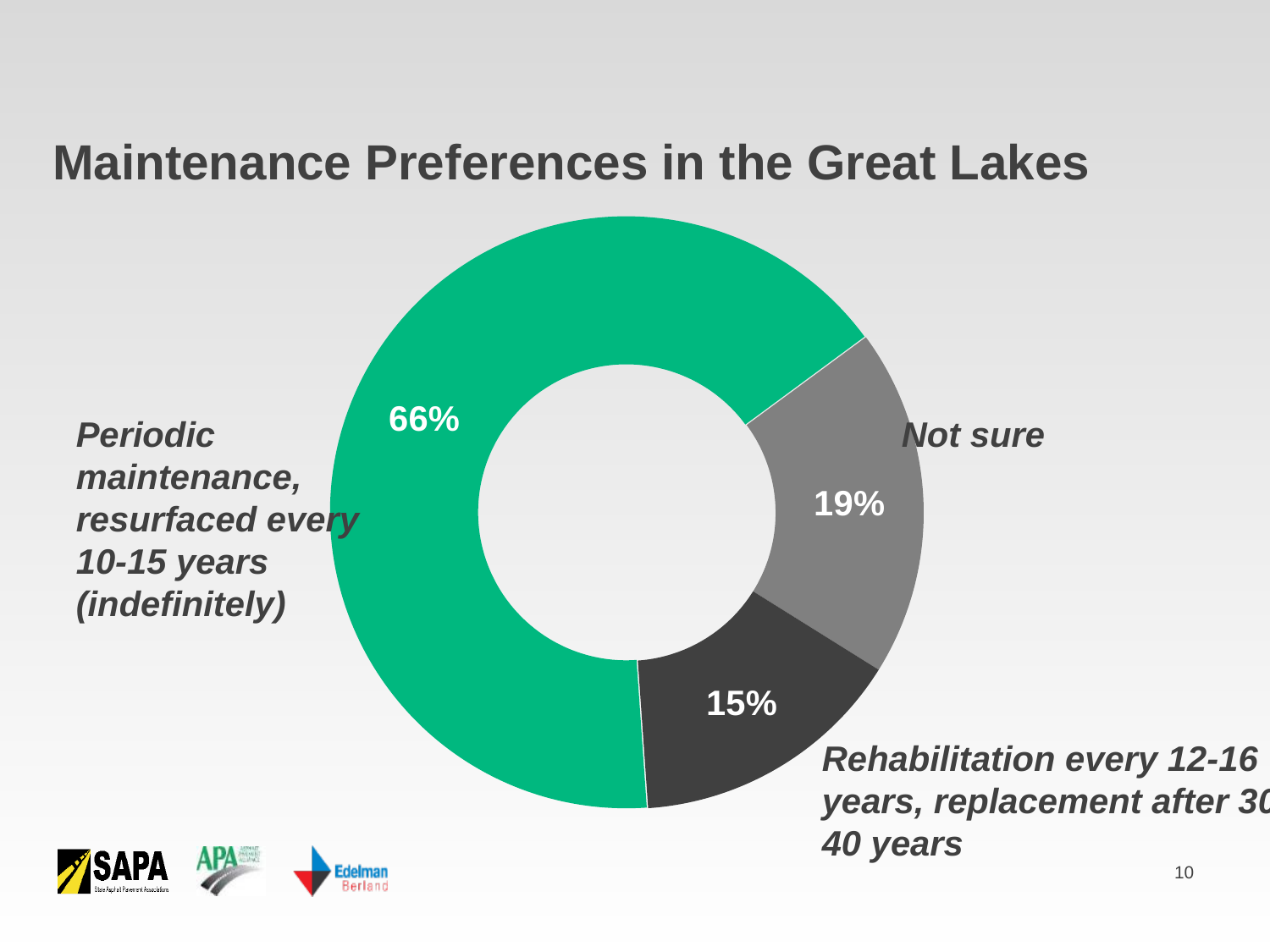
What percentage of respondents prefer rehabilitation every 12-16 years, replacement after 30-40 years? 15% What is the difference in percentage points between the 'Not sure' share and the 'Rehabilitation' share? 4 What percentage of respondents answered 'Not sure'? 19% What colour is the segment representing 66%? Green How many segments does the chart have? 3 What percentage of respondents prefer periodic maintenance, resurfaced every 10-15 years (indefinitely)? 66% What is the difference in percentage points between the 'Periodic maintenance' share and the 'Not sure' share? 47 Which option has the smallest share of the chart? Rehabilitation every 12-16 years, replacement after 30-40 years What is the title of the slide? Maintenance Preferences in the Great Lakes Which option has the largest share of the chart? Periodic maintenance, resurfaced every 10-15 years (indefinitely) What kind of chart is shown on the slide? Doughnut (pie) chart Which is larger: the share for 'Not sure' or the share for 'Rehabilitation every 12-16 years, replacement after 30-40 years'? Not sure